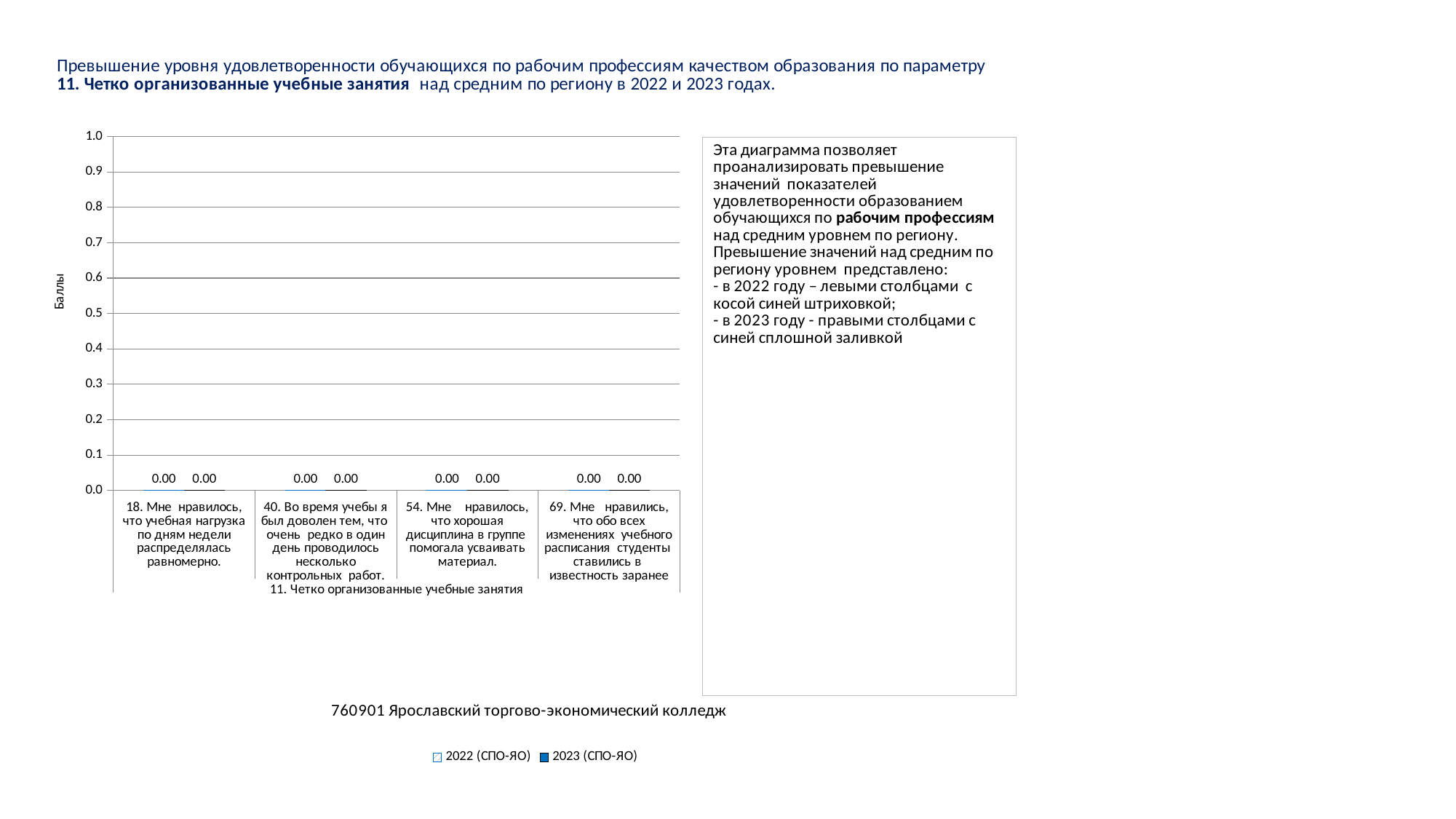
What is the value for 2022 (СПО-ЯО) for category 40 (Во время учебы я был доволен тем, что очень редко в один день проводилось несколько контрольных работ)? 0.00 Is the value for 2023 (СПО-ЯО) for category 40 greater or less than 0.1? less Do the values rise, fall, or stay the same across the categories along the x axis? stay the same What is the value for 2023 (СПО-ЯО) for category 69 (Мне нравились, что обо всех изменениях учебного расписания студенты ставились в известность заранее)? 0.00 How many categories are shown on the x axis of the chart? 4 What kind of chart is shown on the slide? bar chart What are the two series named in the legend? 2022 (СПО-ЯО) and 2023 (СПО-ЯО) How many series does the legend list? 2 What is the difference between the 2022 (СПО-ЯО) and 2023 (СПО-ЯО) values for category 18? 0.00 What is the value for 2022 (СПО-ЯО) for category 18 (Мне нравилось, что учебная нагрузка по дням недели распределялась равномерно)? 0.00 What is the value for 2023 (СПО-ЯО) for category 54 (Мне нравилось, что хорошая дисциплина в группе помогала усваивать материал)? 0.00 What is the label of the vertical axis of the chart? Баллы